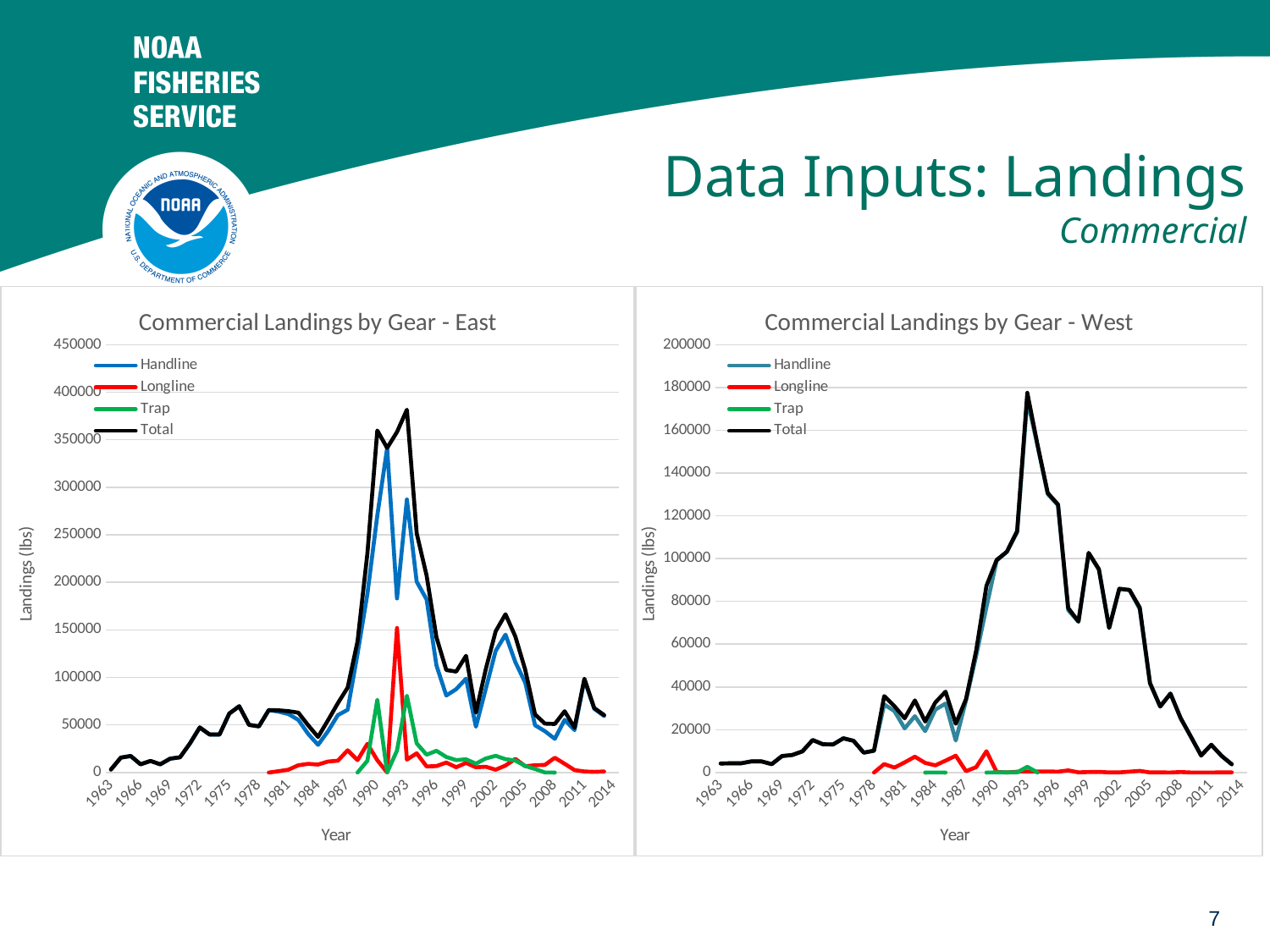
In 'Commercial Landings by Gear - West', is the highest value of the Longline series greater or less than 20000? less In 'Commercial Landings by Gear - East', is the peak value of the Total series greater or less than 350000? greater Does the Total series in 'Commercial Landings by Gear - West' rise or fall between 2005 and 2014? fall Which chart has the higher peak Total value, 'Commercial Landings by Gear - East' or 'Commercial Landings by Gear - West'? Commercial Landings by Gear - East In 'Commercial Landings by Gear - East', is the peak value of the Trap series greater or less than 50000? greater How many series does the legend of 'Commercial Landings by Gear - West' list? 4 What type of chart is 'Commercial Landings by Gear - East'? line chart In 'Commercial Landings by Gear - East', which gear series (excluding Total) reaches the highest peak? Handline In 'Commercial Landings by Gear - West', which gear series (excluding Total) reaches the highest peak? Handline What is the y-axis label on 'Commercial Landings by Gear - West'? Landings (lbs) What are the legend entries in 'Commercial Landings by Gear - East'? Handline, Longline, Trap, Total